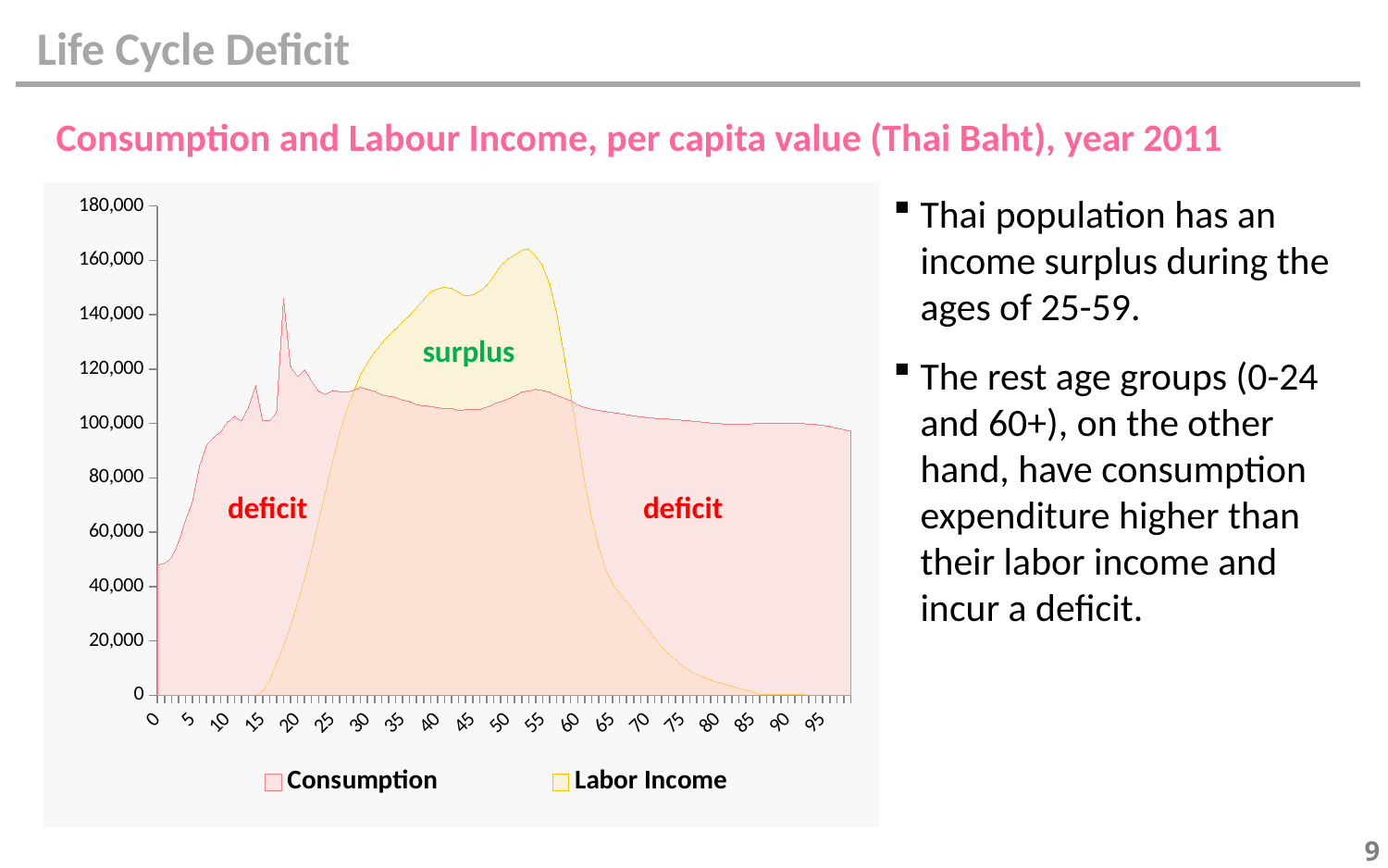
What is the title of the chart on the slide? Consumption and Labour Income, per capita value (Thai Baht), year 2011 What kind of chart is shown on the slide? Area chart What are the two series named in the chart legend? Consumption and Labor Income At age 10, which is larger, Consumption or Labor Income? Consumption At age 40, which is larger, Consumption or Labor Income? Labor Income Is the Labor Income value at age 80 greater or less than 20,000? less Is the Labor Income value at age 50 greater or less than 140,000? greater Does Labor Income rise or fall between ages 55 and 75? fall How many series does the chart legend list? 2 At age 70, which is larger, Consumption or Labor Income? Consumption Which series reaches the highest value anywhere on the chart, Consumption or Labor Income? Labor Income Is the Consumption value at age 80 greater or less than 80,000? greater